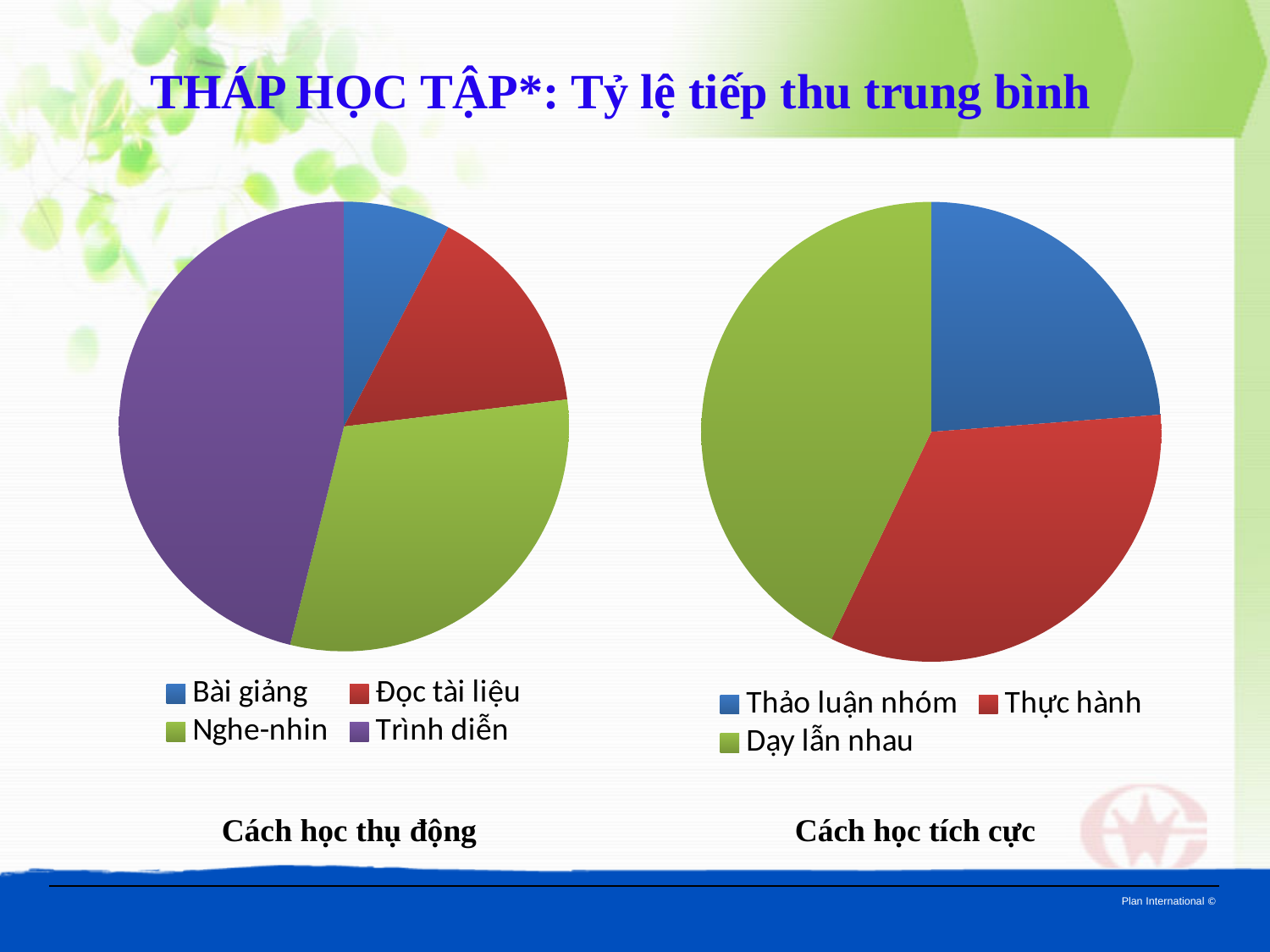
In the right chart (Cách học tích cực), what colour is the slice for Thực hành? red What kind of chart is the left chart, labelled "Cách học thụ động"? pie chart In the left chart (Cách học thụ động), which category has the largest slice? Trình diễn In the right chart (Cách học tích cực), which category has the smallest slice? Thảo luận nhóm In the left chart (Cách học thụ động), which category has the smallest slice? Bài giảng What kind of chart is the right chart, labelled "Cách học tích cực"? pie chart How many entries does the legend of the left chart (Cách học thụ động) list? 4 In the right chart (Cách học tích cực), how many slices does the pie have? 3 In the left chart (Cách học thụ động), how many slices does the pie have? 4 How many entries does the legend of the right chart (Cách học tích cực) list? 3 In the left chart (Cách học thụ động), which slice is larger: Nghe-nhìn or Đọc tài liệu? Nghe-nhìn In the right chart (Cách học tích cực), which category has the largest slice? Dạy lẫn nhau